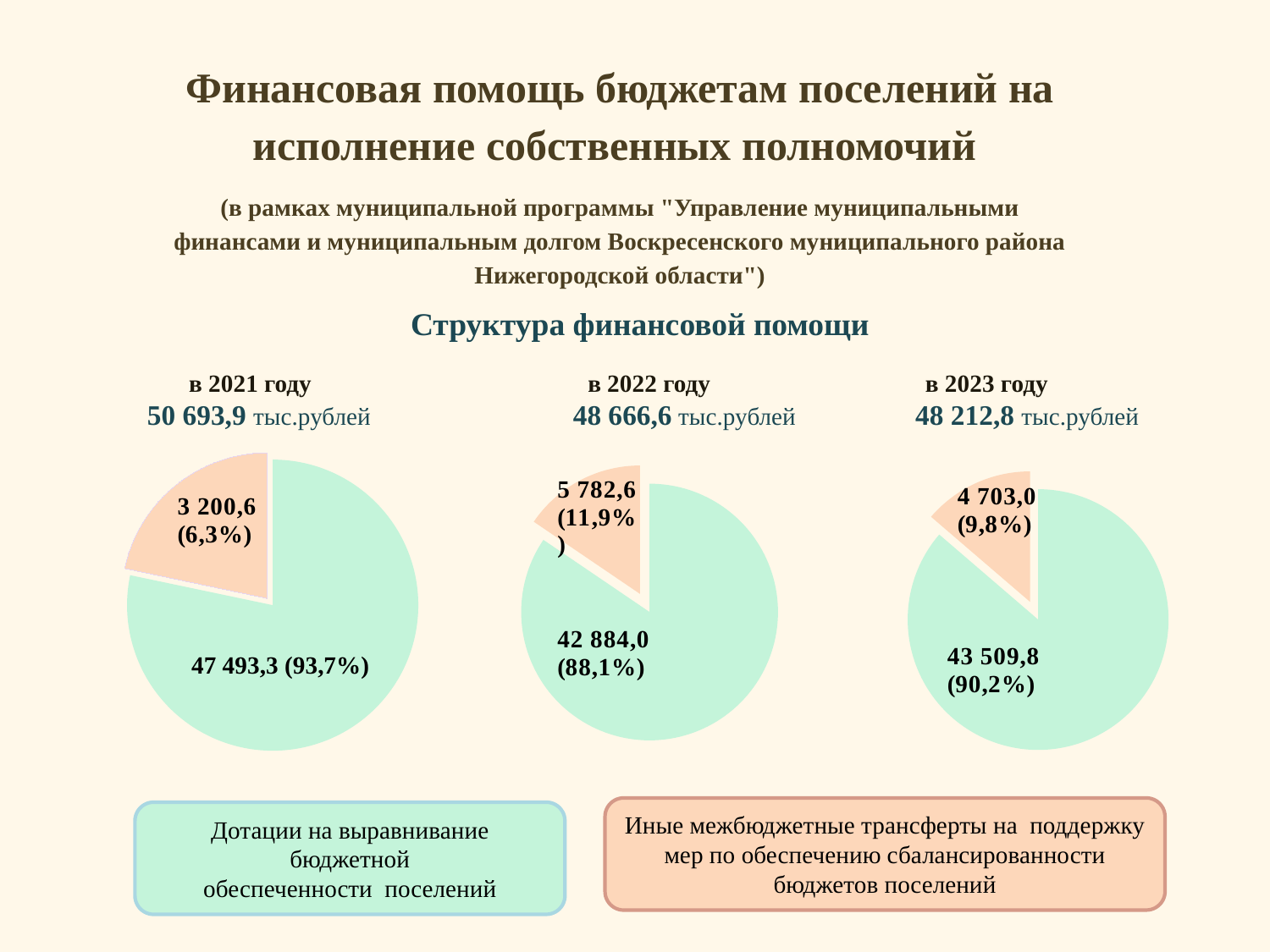
Across the three pie charts, in which year does Иные межбюджетные трансферты have the largest share? 2022 (11,9%) In the pie chart for 2021 (в 2021 году), what share of the pie is Иные межбюджетные трансферты на поддержку мер по обеспечению сбалансированности бюджетов поселений? 6,3% What total amount is shown above the pie chart for 2022 (в 2022 году)? 48 666,6 тыс.рублей In the pie chart for 2021 (в 2021 году), what is the value for Дотации на выравнивание бюджетной обеспеченности поселений? 47 493,3 In the pie chart for 2022 (в 2022 году), what is the value for Иные межбюджетные трансферты на поддержку мер по обеспечению сбалансированности бюджетов поселений? 5 782,6 In the pie chart for 2023 (в 2023 году), what is the value for Дотации на выравнивание бюджетной обеспеченности поселений? 43 509,8 What kind of chart is used to show the structure of financial assistance for each year? Pie chart In the pie chart for 2021 (в 2021 году), what is the difference between the value for Дотации на выравнивание (47 493,3) and the value for Иные межбюджетные трансферты (3 200,6)? 44 292,7 In the pie chart for 2022 (в 2022 году), what share of the pie is Дотации на выравнивание бюджетной обеспеченности поселений? 88,1% In the pie chart for 2023 (в 2023 году), which is larger: Дотации на выравнивание бюджетной обеспеченности поселений or Иные межбюджетные трансферты? Дотации на выравнивание бюджетной обеспеченности поселений In the pie chart for 2023 (в 2023 году), what share of the pie is Иные межбюджетные трансферты на поддержку мер по обеспечению сбалансированности бюджетов поселений? 9,8% How many slices does the pie chart for 2021 (в 2021 году) have? 2